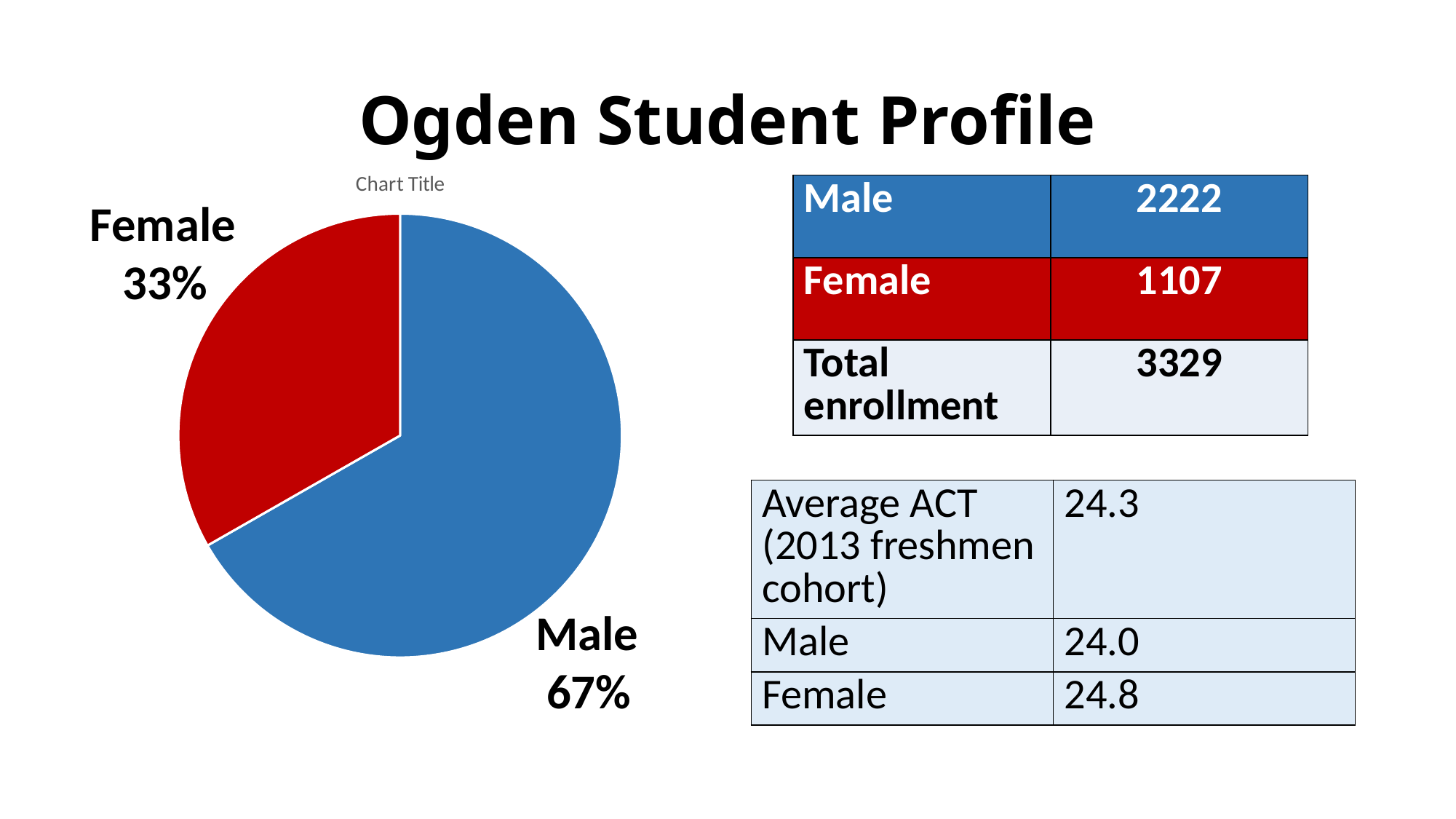
What kind of chart is shown on the slide? pie chart What is the difference in percentage points between the Male and Female slices of the pie chart? 34 What colour is the Female slice of the pie chart? red What percentage of the pie chart is labelled Male? 67% What percentage of the pie chart is labelled Female? 33% Which slice is larger in the pie chart, Male or Female? Male How many slices does the pie chart have? 2 What colour is the Male slice of the pie chart? blue Which slice of the pie chart is the largest? Male Which slice of the pie chart is the smallest? Female